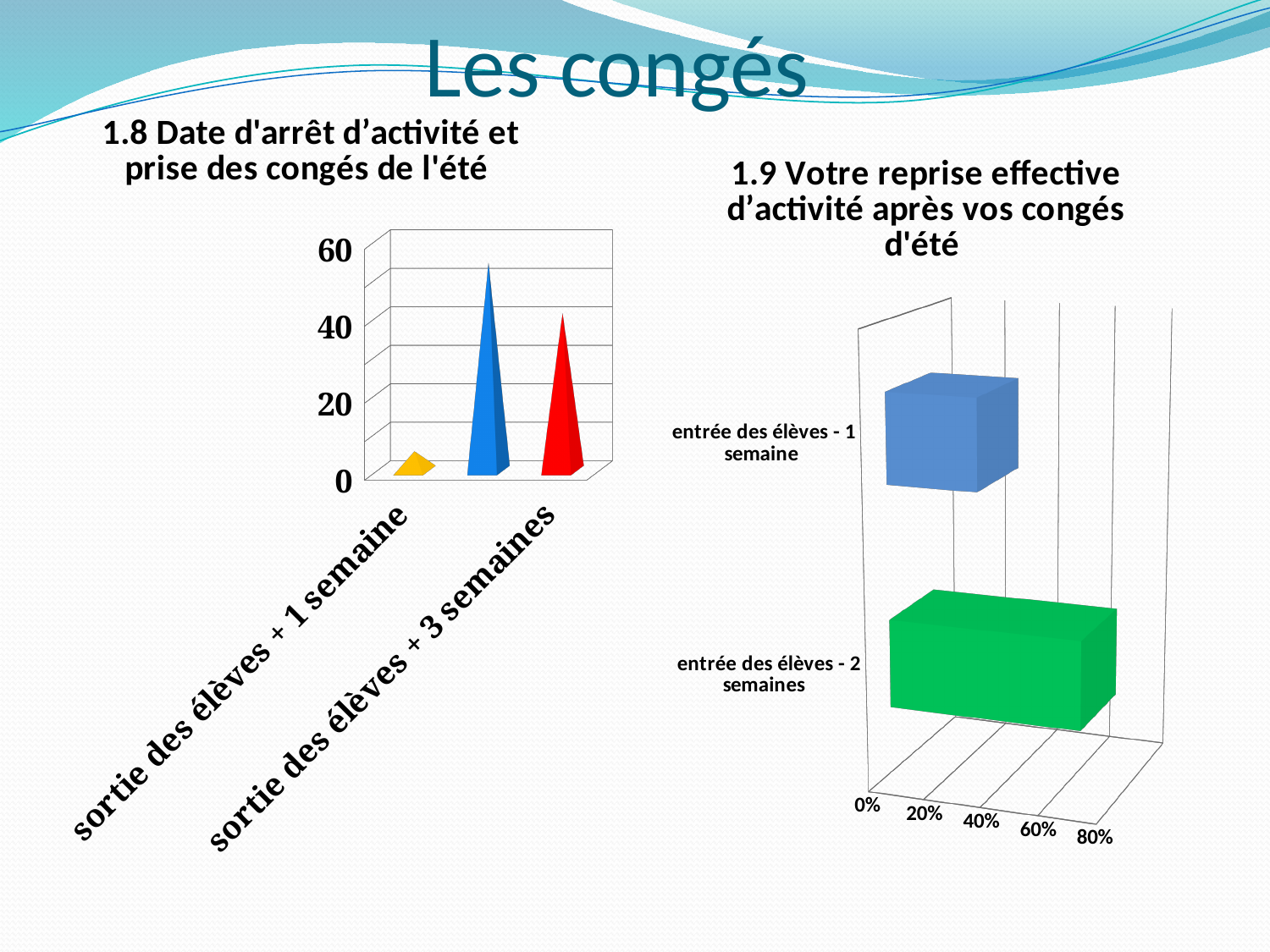
In the left chart '1.8 Date d'arrêt d'activité', which category has the lowest value? sortie des élèves + 1 semaine In the left chart '1.8 Date d'arrêt d'activité', is the value for 'sortie des élèves + 1 semaine' greater or less than 20? less In the left chart '1.8 Date d'arrêt d'activité', which is larger: 'sortie des élèves + 1 semaine' or 'sortie des élèves + 3 semaines'? sortie des élèves + 3 semaines In the left chart '1.8 Date d'arrêt d'activité', how many categories are plotted? 3 What kind of chart is the left chart, '1.8 Date d'arrêt d'activité et prise des congés de l'été'? bar chart In the right chart '1.9 Votre reprise effective d'activité', is the value for 'entrée des élèves - 1 semaine' greater or less than 60%? less In the right chart '1.9 Votre reprise effective d'activité', what colour is the bar for 'entrée des élèves - 2 semaines'? green In the left chart '1.8 Date d'arrêt d'activité', is the value for 'sortie des élèves + 3 semaines' greater or less than 20? greater In the right chart '1.9 Votre reprise effective d'activité', how many categories are plotted? 2 In the right chart '1.9 Votre reprise effective d'activité', which category has the highest value? entrée des élèves - 2 semaines What kind of chart is the right chart, '1.9 Votre reprise effective d'activité après vos congés d'été'? bar chart